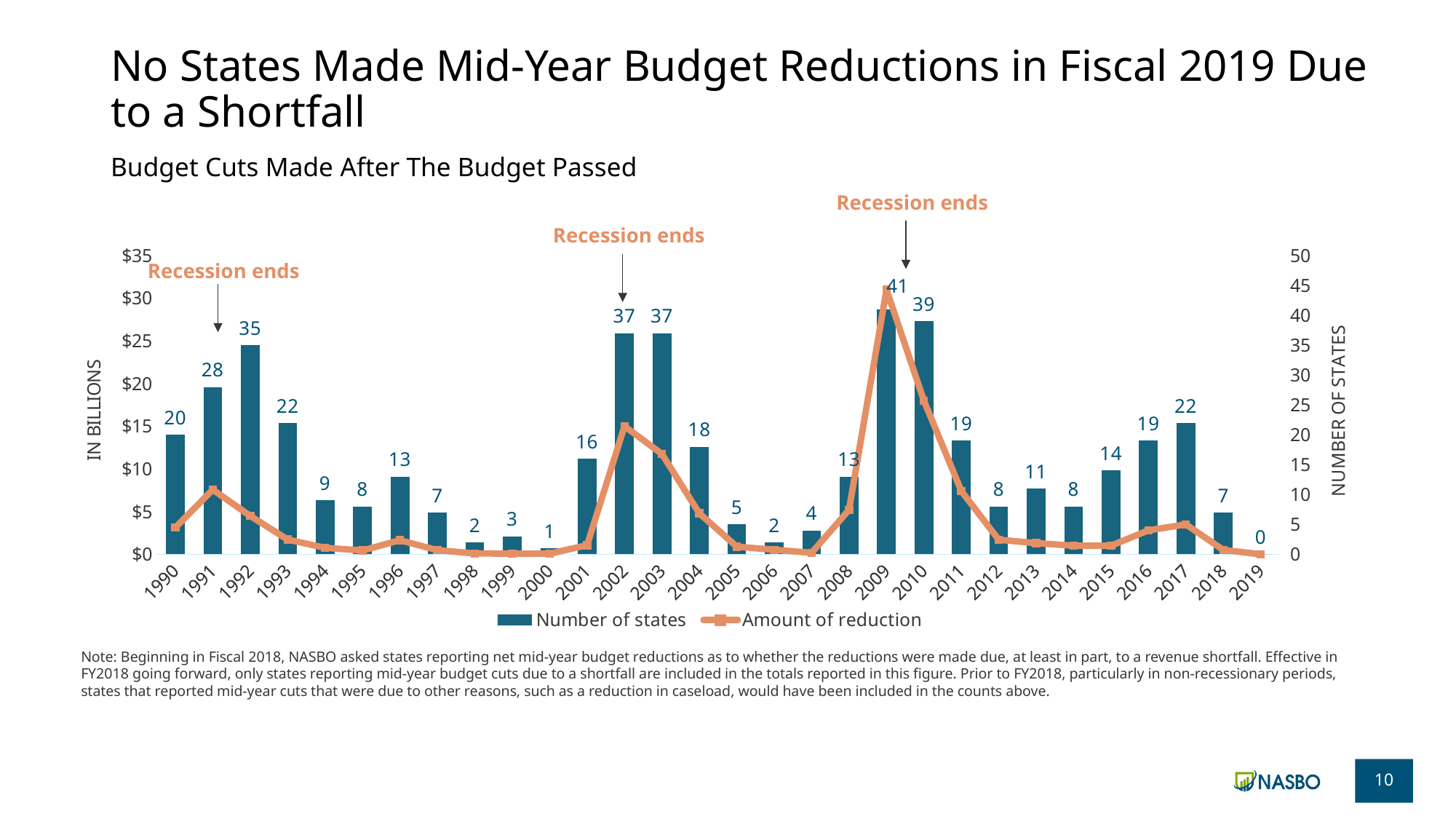
How many states made mid-year budget reductions in 2009? 41 How many series does the legend list? 2 Which year has the highest number of states? 2009 Does the number of states rise or fall from 2009 to 2012? fall What is the number of states shown for 2019? 0 What is the number of states shown for 1992? 35 Which year has the lowest number of states? 2019 What is the difference in the number of states between 2010 and 2011? 20 Which year has a larger number of states, 1991 or 2017? 1991 Is the amount of reduction in 2009 greater or less than $25 billion? greater Is the amount of reduction in 2019 greater or less than $5 billion? less How many years are shown on the x axis? 30